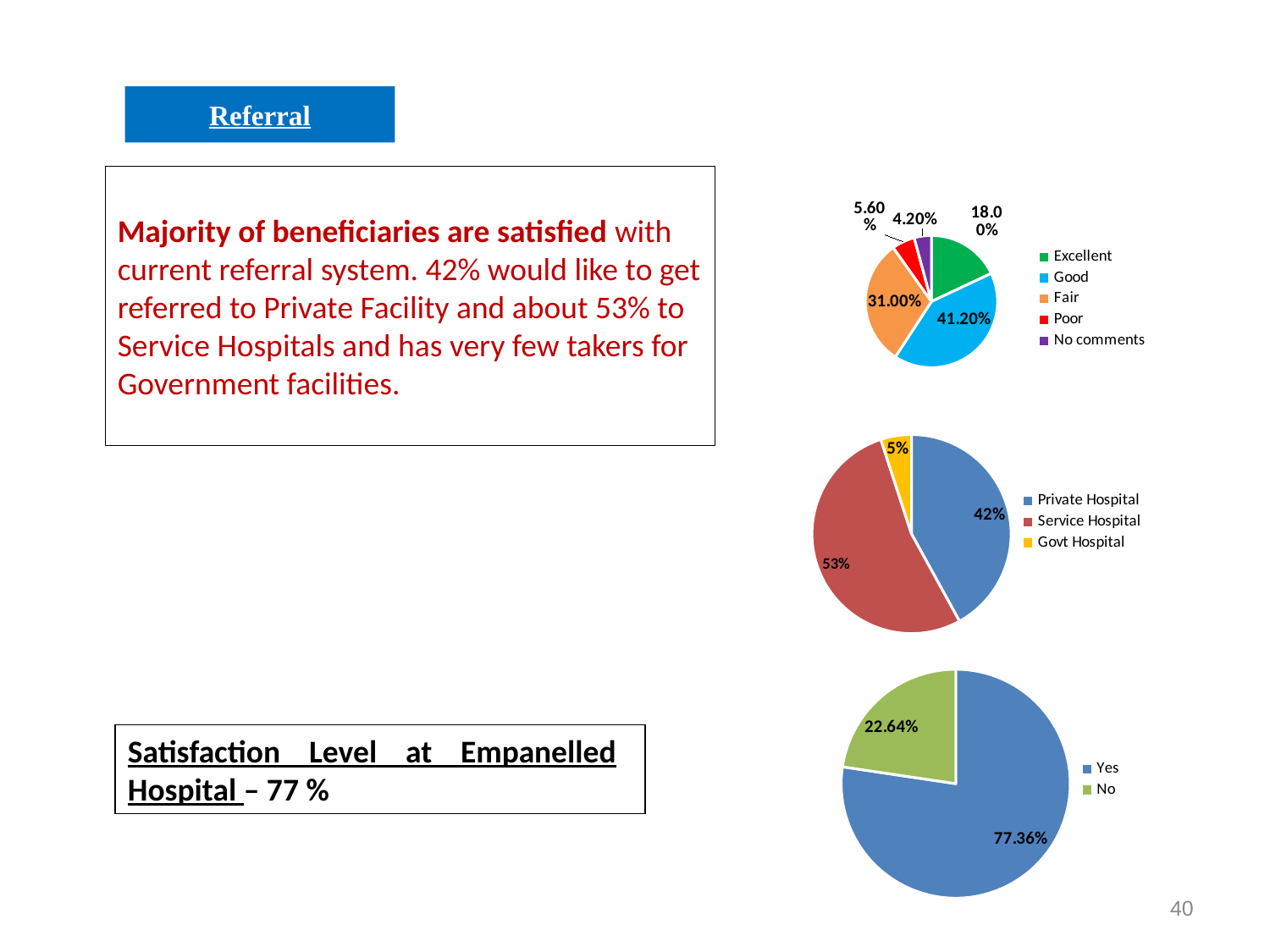
In the top pie chart on the right, what is the difference between the Good and Fair shares? 10.20% In the middle pie chart on the right, what percentage is shown for Service Hospital? 53% In the middle pie chart on the right, which category has the smallest share? Govt Hospital In the top pie chart on the right, which category has the smallest share? No comments In the bottom pie chart on the right, what percentage is shown for No? 22.64% In the top pie chart on the right, what percentage is shown for Fair? 31.00% In the top pie chart on the right, what percentage is shown for Good? 41.20% In the middle pie chart on the right, which is larger, Private Hospital or Service Hospital? Service Hospital In the top pie chart on the right, which category has the largest share? Good In the top pie chart on the right, how many categories does the legend list? 5 What type of chart is the bottom chart on the right? Pie chart In the bottom pie chart on the right, what is the difference between the Yes and No shares? 54.72%